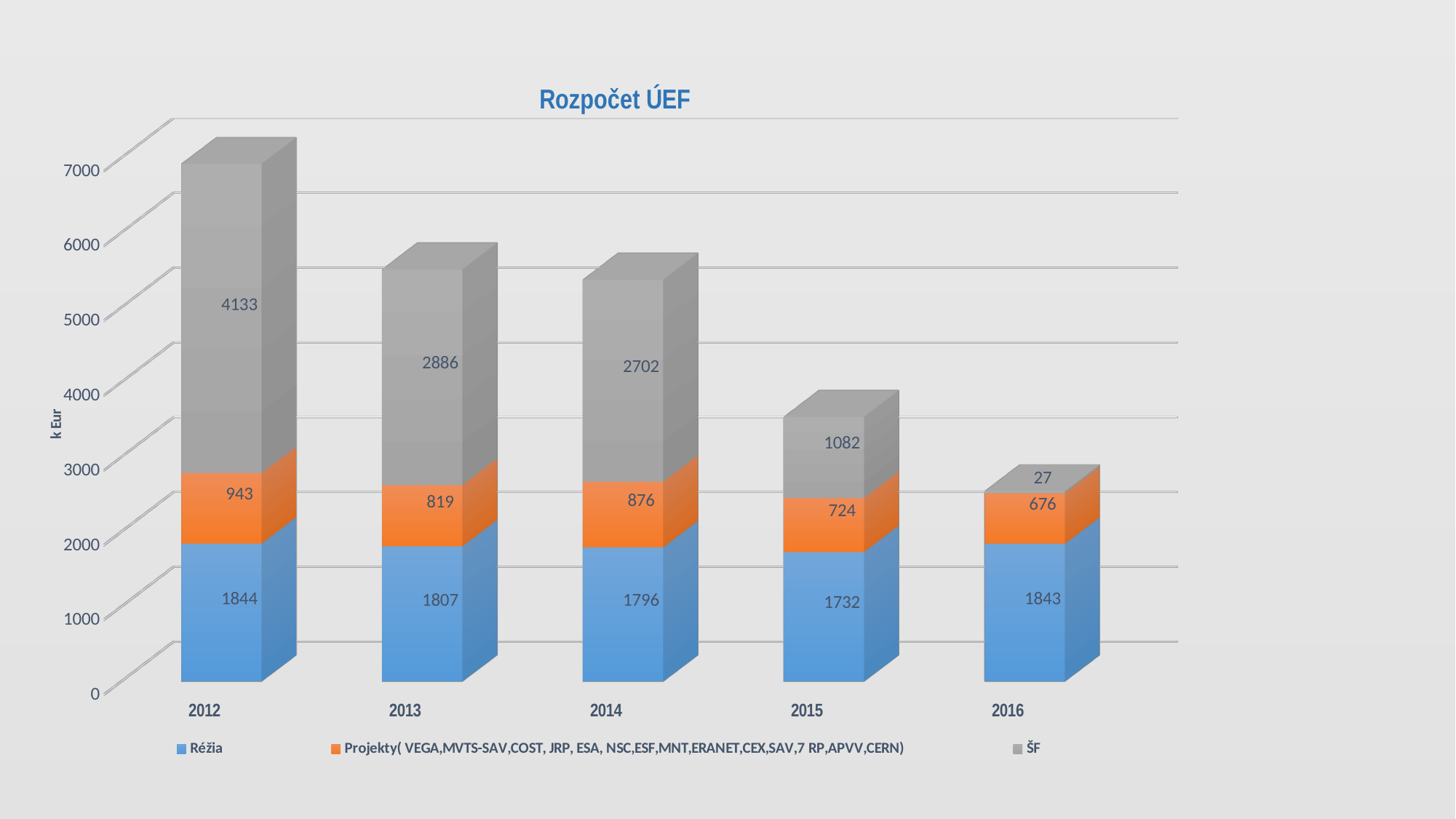
How many years are shown on the x axis? 5 What is the Réžia value for 2015? 1732 What is the total of the stacked bar for 2015? 3538 Which year has the lowest ŠF value? 2016 What is the value of ŠF for 2012? 4133 Which year has the highest ŠF value? 2012 What is the Projekty value for 2014? 876 What is the title of the chart? Rozpočet ÚEF What is the difference between the ŠF values for 2013 and 2014? 184 What is the total of the stacked bar for 2016? 2546 How many series does the legend list? 3 Which is larger, the Réžia value for 2012 or for 2016? 2012